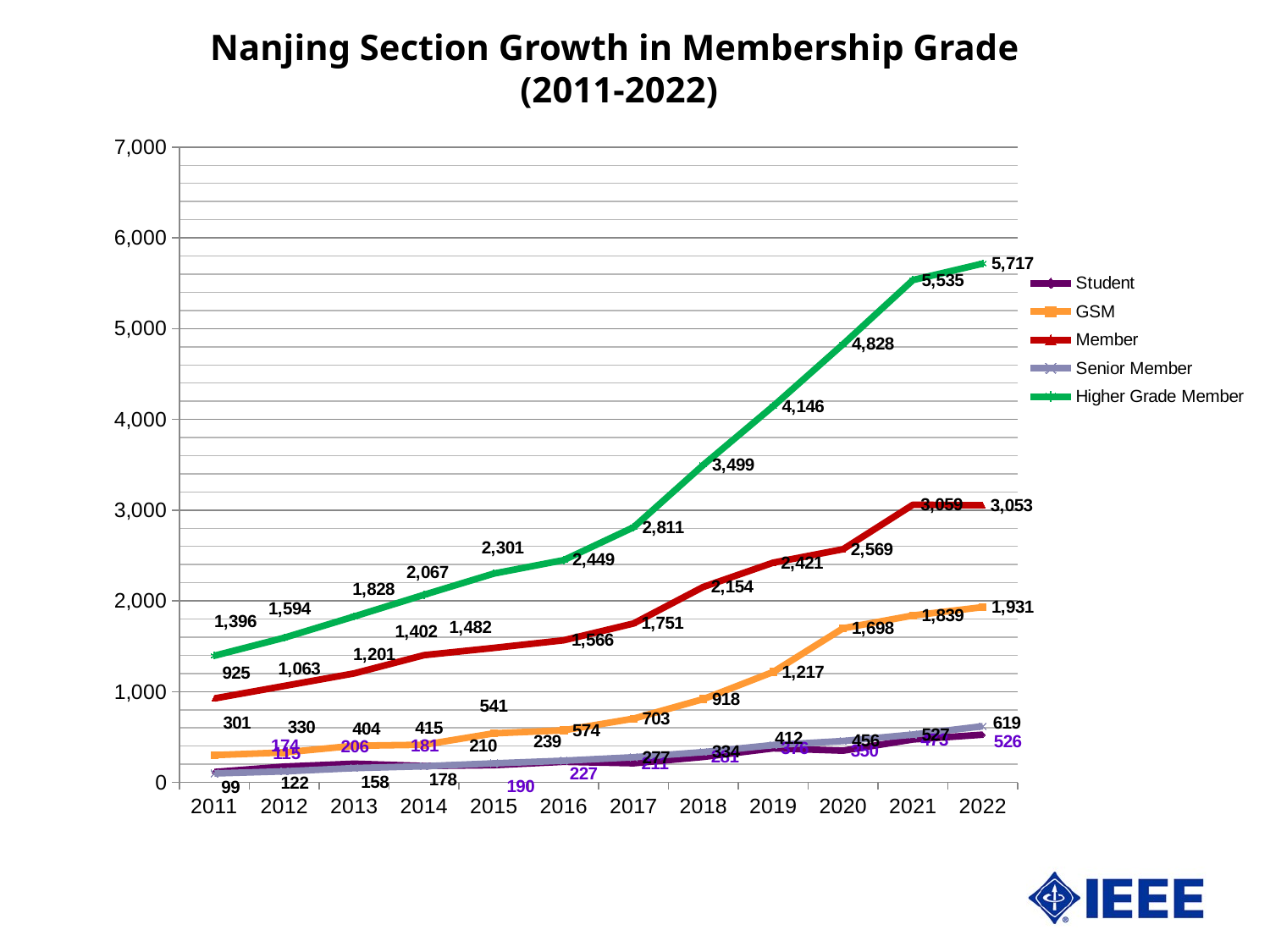
What is the GSM value for 2020? 1,698 What is the Higher Grade Member value for 2022? 5,717 Does the Higher Grade Member series rise or fall from 2011 to 2022? rise How many years are plotted along the x axis? 12 By how much did the Higher Grade Member value increase from 2011 to 2022? 4,321 Is the GSM value for 2018 greater or less than 1,000? less What is the Senior Member value for 2019? 412 Which is larger in 2019, the GSM value or the Member value? Member Which series has the highest value in 2022? Higher Grade Member How many series does the legend list? 5 What kind of chart is shown on the slide? line chart What is the Member value for 2018? 2,154